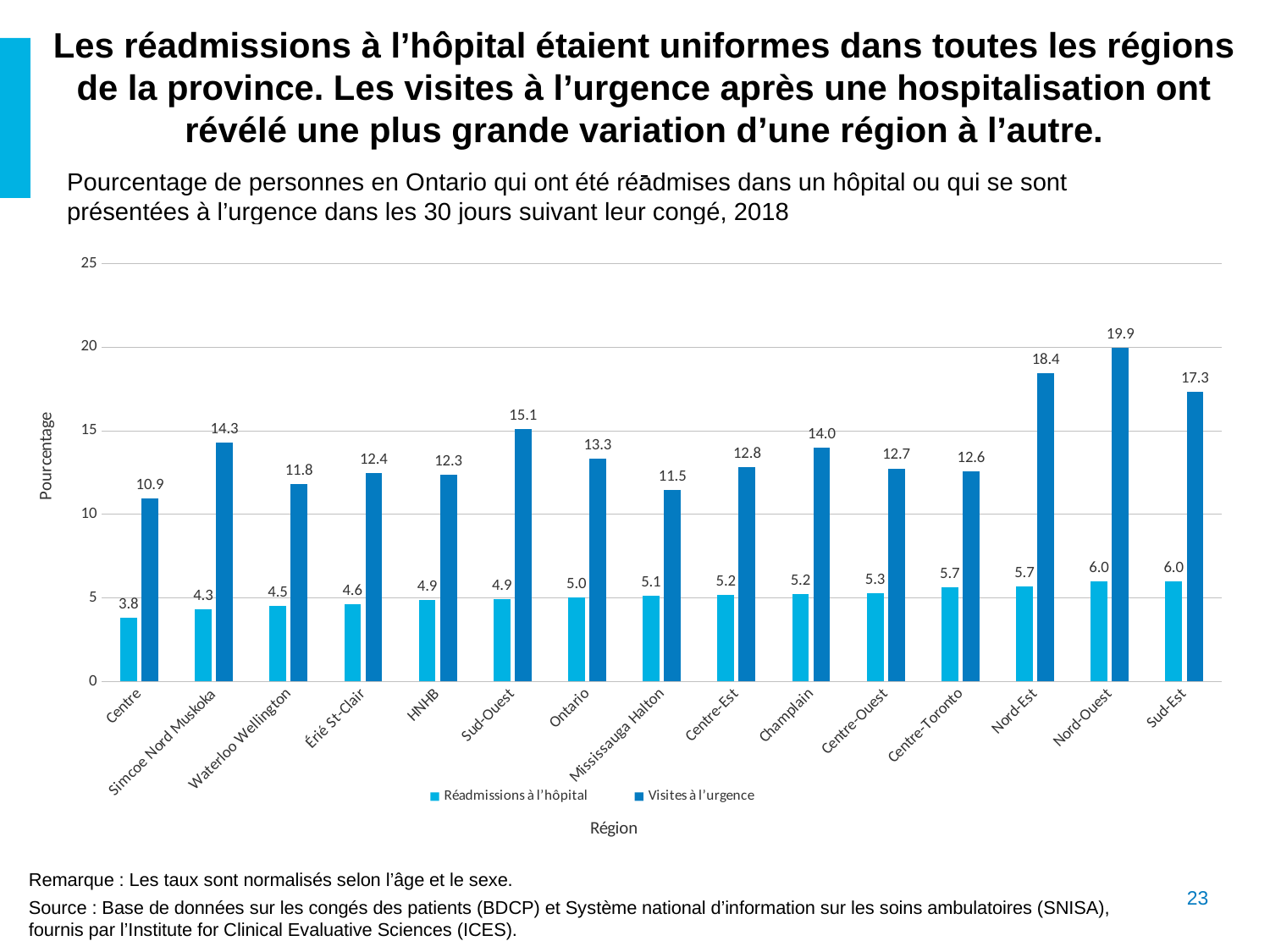
Which region has the lowest value for Visites à l'urgence? Centre What is the value for Visites à l'urgence in Nord-Ouest? 19.9 How many regions are shown on the x axis? 15 Which is larger: Visites à l'urgence in Sud-Ouest or in Ontario? Sud-Ouest What is the value for Réadmissions à l'hôpital in Ontario? 5.0 What is the difference between Visites à l'urgence and Réadmissions à l'hôpital in Nord-Ouest? 13.9 What kind of chart is shown on the slide? Bar chart What is the value for Visites à l'urgence in Champlain? 14.0 How many series does the legend list? 2 Which region has the lowest value for Réadmissions à l'hôpital? Centre Which region has the highest value for Visites à l'urgence? Nord-Ouest What is the label of the y axis? Pourcentage